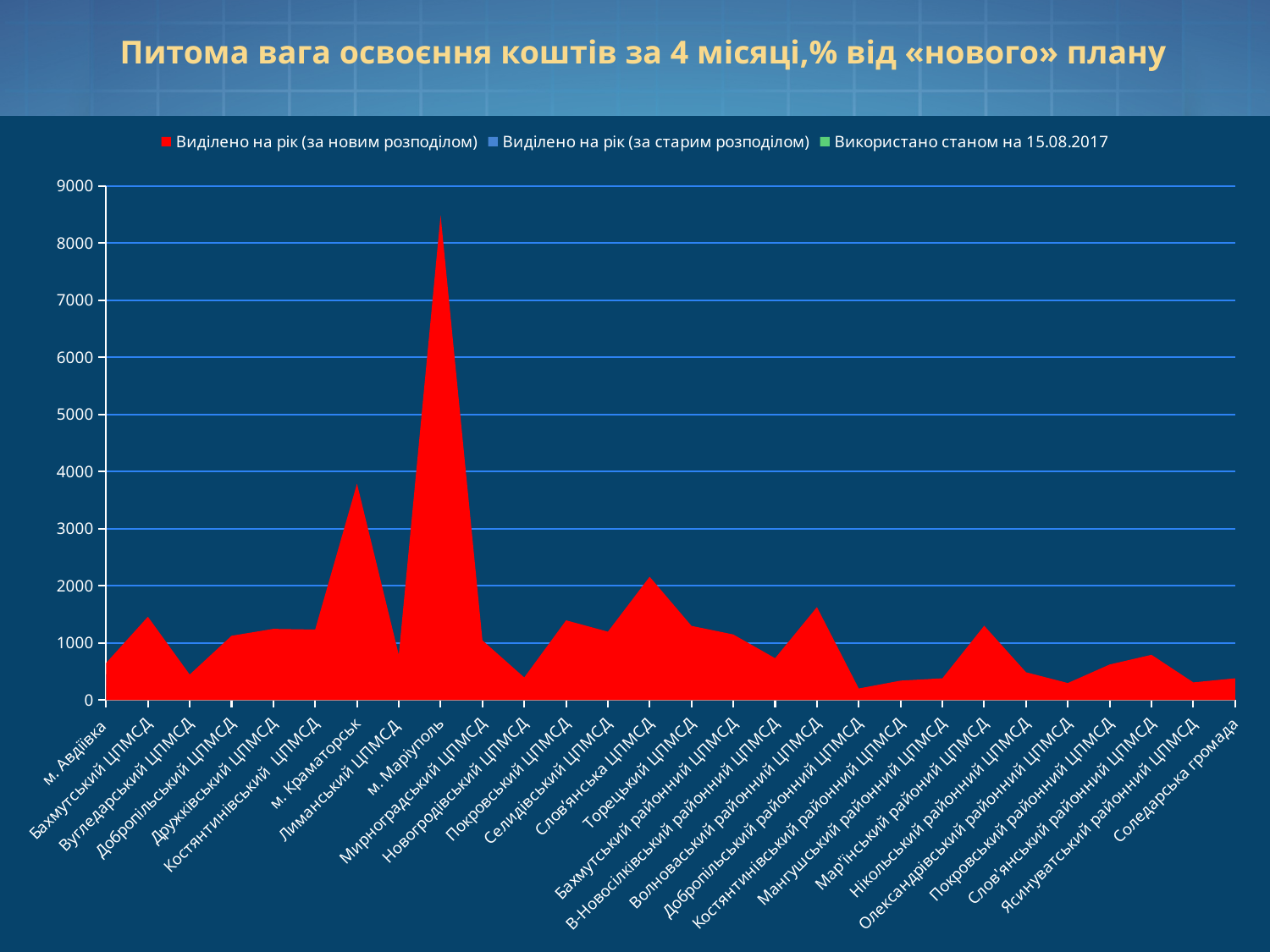
Is the value for м. Краматорськ greater or less than 3000? greater Is the value for м. Краматорськ greater or less than 4000? less How many categories are shown along the x axis? 28 How many series does the legend list? 3 Is the value for Костянтинівський районний ЦПМСД greater or less than 1000? less Which is larger, the value for м. Краматорськ or the value for Слов'янська ЦПМСД? м. Краматорськ Which is larger, the value for м. Маріуполь or the value for м. Краматорськ? м. Маріуполь What kind of chart is shown on the slide? area chart What is the title of the chart? Питома вага освоєння коштів за 4 місяці,% від «нового» плану Which category has the highest value? м. Маріуполь